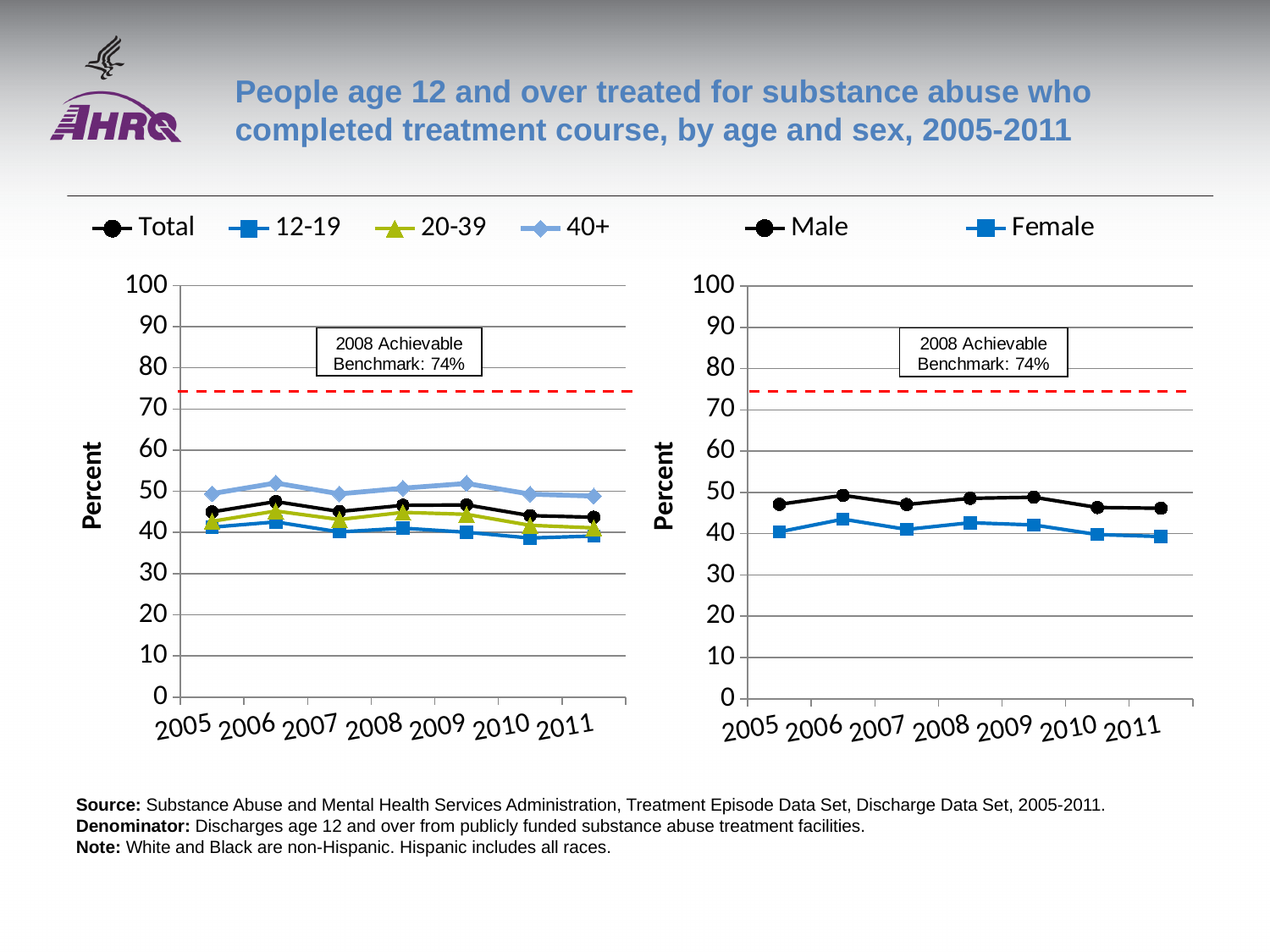
In the left chart (by age), is the value for 40+ in 2009 greater or less than 50? greater In the left chart (by age), which age group has the highest values across all years? 40+ What kind of chart is the left chart (by age)? line chart How many series does the legend of the left chart (by age) list? 4 What is the 2008 Achievable Benchmark shown on the charts? 74% How many series does the legend of the right chart (by sex) list? 2 In the right chart (by sex), is the value for Male in 2006 greater or less than 60? less In the left chart (by age), do the Total values rise or fall from 2009 to 2011? fall In the right chart (by sex), which series is higher in 2011, Male or Female? Male In the left chart (by age), which age group has the lowest values across all years? 12-19 How many years are plotted along the x axis of the right chart (by sex)? 7